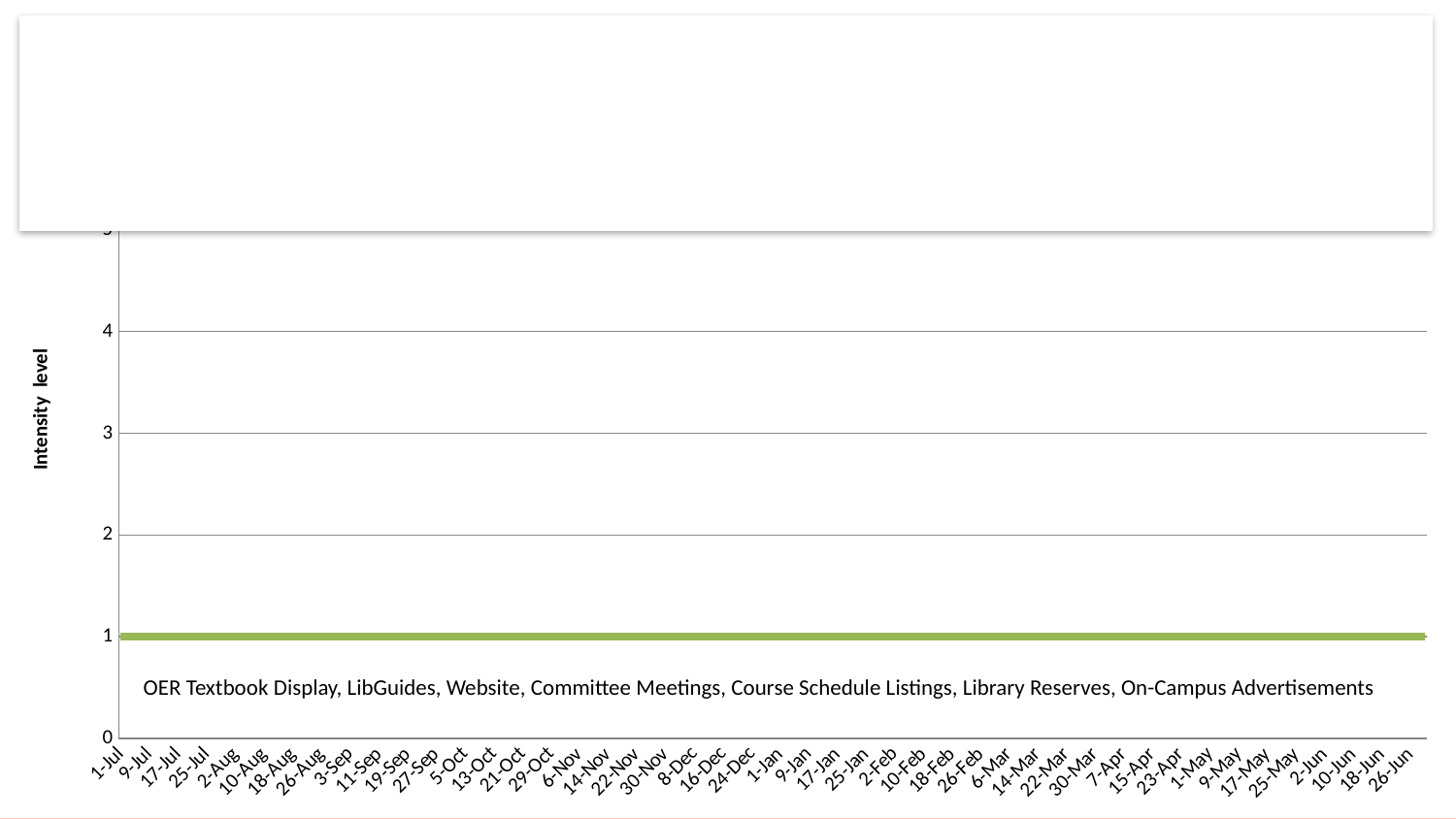
What is the first date label on the horizontal axis? 1-Jul Is the value plotted on 14-Nov greater or less than 2? less Does the plotted line rise, fall, or stay flat from 1-Jul to 26-Jun? stays flat What is the last date label on the horizontal axis? 26-Jun What is the label of the vertical axis? Intensity level What is the difference between the intensity level on 1-Jul and on 26-Jun? 0 What is the intensity level plotted on 1-Jul? 1 What is the highest intensity level reached by the plotted line? 1 What is the intensity level plotted on 1-Jan? 1 What kind of chart is shown on the slide? line chart What is the intensity level plotted on 26-Jun? 1